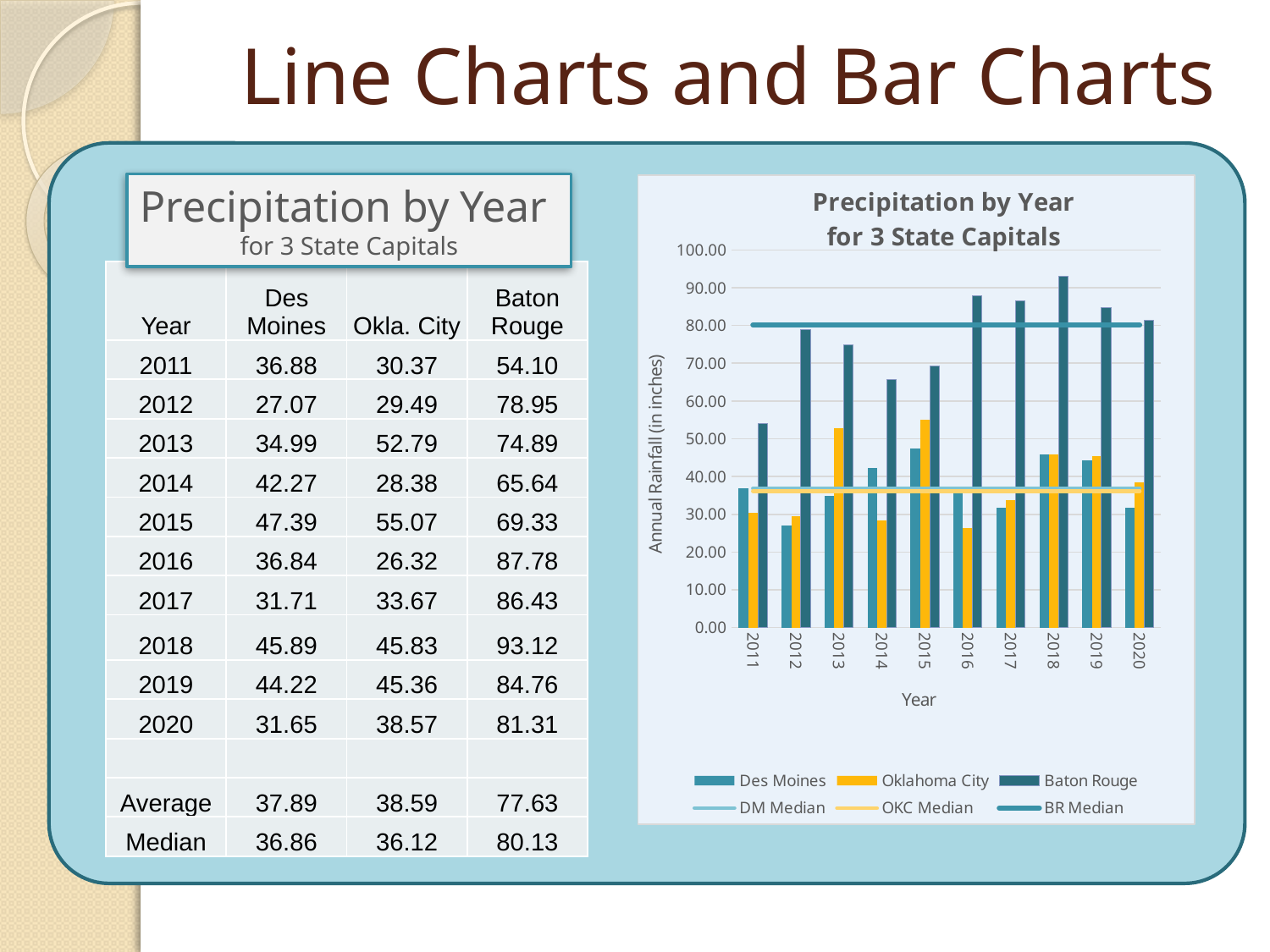
Is the Baton Rouge value for 2016 greater or less than 80.00? greater In 2013, which is larger: the Oklahoma City bar or the Des Moines bar? Oklahoma City What is the Des Moines precipitation value for 2015? 47.39 What is the difference between the Baton Rouge and Des Moines values for 2018? 47.23 In which year is the Des Moines bar lowest? 2012 In which year is the Baton Rouge bar highest? 2018 What is the label on the vertical axis of the chart? Annual Rainfall (in inches) Is the Oklahoma City value for 2016 greater or less than 30.00? less How many years are shown along the x axis of the chart? 10 What kind of chart is shown on the slide? combination bar and line chart How many series does the chart legend list? 6 Do the Des Moines values rise or fall from 2018 to 2020? fall